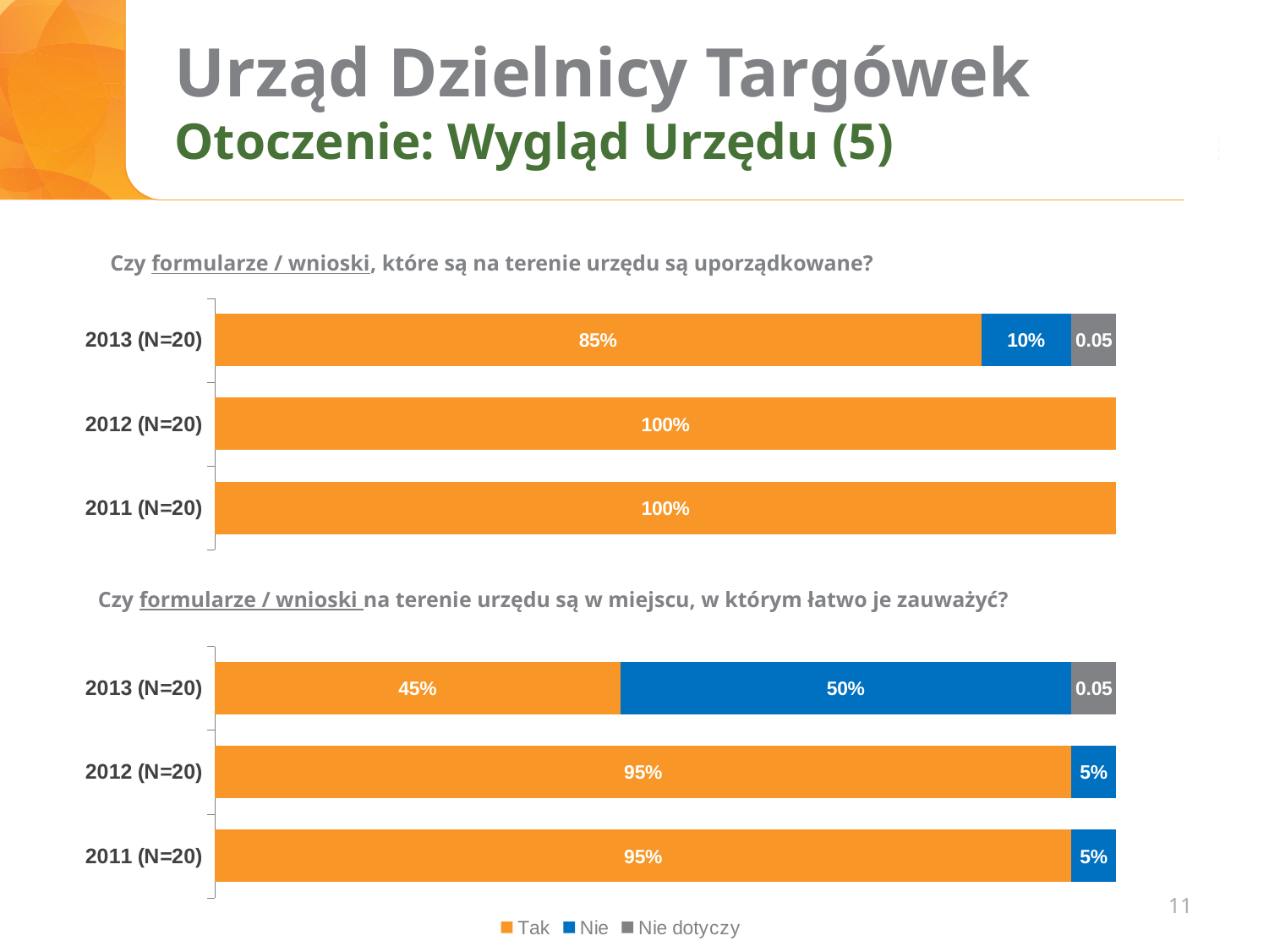
In the bottom chart ("Czy formularze / wnioski na terenie urzędu są w miejscu, w którym łatwo je zauważyć?"), what is the difference between the "Tak" values for 2012 (N=20) and 2013 (N=20)? 50% In the bottom chart ("Czy formularze / wnioski na terenie urzędu są w miejscu, w którym łatwo je zauważyć?"), which is larger for 2013 (N=20): the "Tak" value or the "Nie" value? Nie In the top chart ("Czy formularze / wnioski, które są na terenie urzędu są uporządkowane?"), what is the "Tak" value for 2012 (N=20)? 100% In the top chart ("Czy formularze / wnioski, które są na terenie urzędu są uporządkowane?"), which year has the lowest "Tak" value? 2013 (N=20) How many series does the legend at the bottom of the slide list? 3 In the top chart ("Czy formularze / wnioski, które są na terenie urzędu są uporządkowane?"), what is the difference between the "Tak" values for 2012 (N=20) and 2013 (N=20)? 15% In the top chart ("Czy formularze / wnioski, które są na terenie urzędu są uporządkowane?"), what is the "Nie" value for 2013 (N=20)? 10% In the bottom chart ("Czy formularze / wnioski na terenie urzędu są w miejscu, w którym łatwo je zauważyć?"), what is the "Nie" value for 2013 (N=20)? 50% In the top chart ("Czy formularze / wnioski, które są na terenie urzędu są uporządkowane?"), what is the "Tak" value for 2013 (N=20)? 85% What type of chart is the top chart ("Czy formularze / wnioski, które są na terenie urzędu są uporządkowane?")? Stacked bar chart How many year categories does the bottom chart ("Czy formularze / wnioski na terenie urzędu są w miejscu, w którym łatwo je zauważyć?") show? 3 In the bottom chart ("Czy formularze / wnioski na terenie urzędu są w miejscu, w którym łatwo je zauważyć?"), what is the "Tak" value for 2011 (N=20)? 95%